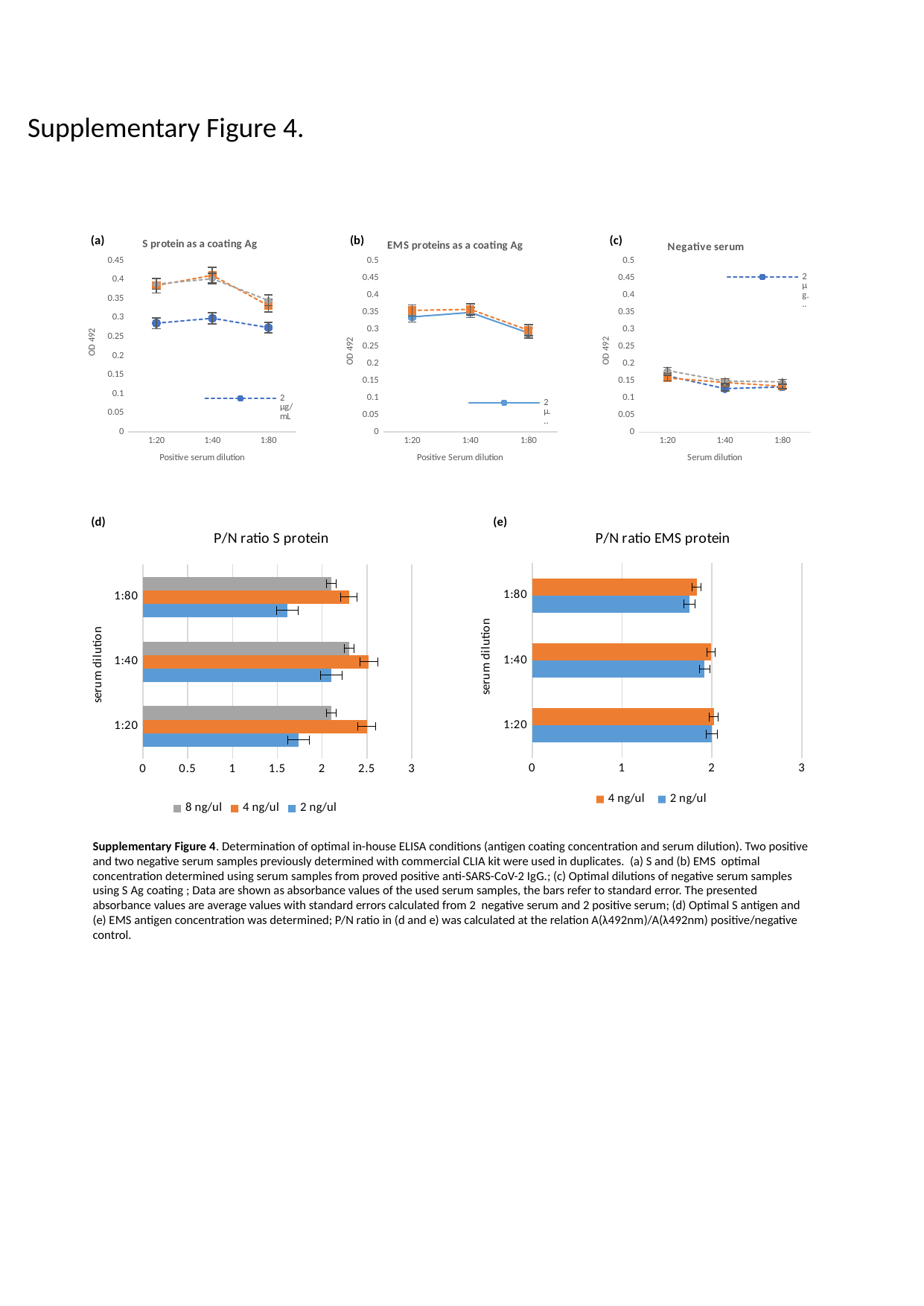
In the 'S protein as a coating Ag' chart, is the blue series value at 1:20 greater or less than 0.3? less What type of chart is the 'S protein as a coating Ag' chart? line chart In the 'P/N ratio S protein' chart, is the value for 2 ng/ul at 1:80 greater or less than 2? less In the 'Negative serum' chart, is the gray series value at 1:20 greater or less than 0.2? less What type of chart is the 'P/N ratio S protein' chart? bar chart How many serum dilution categories are shown on the x axis of the 'EMS proteins as a coating Ag' chart? 3 How many series does the legend of the 'P/N ratio EMS protein' chart list? 2 What is the y-axis label of the 'Negative serum' chart? OD 492 In the 'P/N ratio S protein' chart, which is larger at 1:80, the 4 ng/ul bar or the 2 ng/ul bar? 4 ng/ul How many series does the legend of the 'P/N ratio S protein' chart list? 3